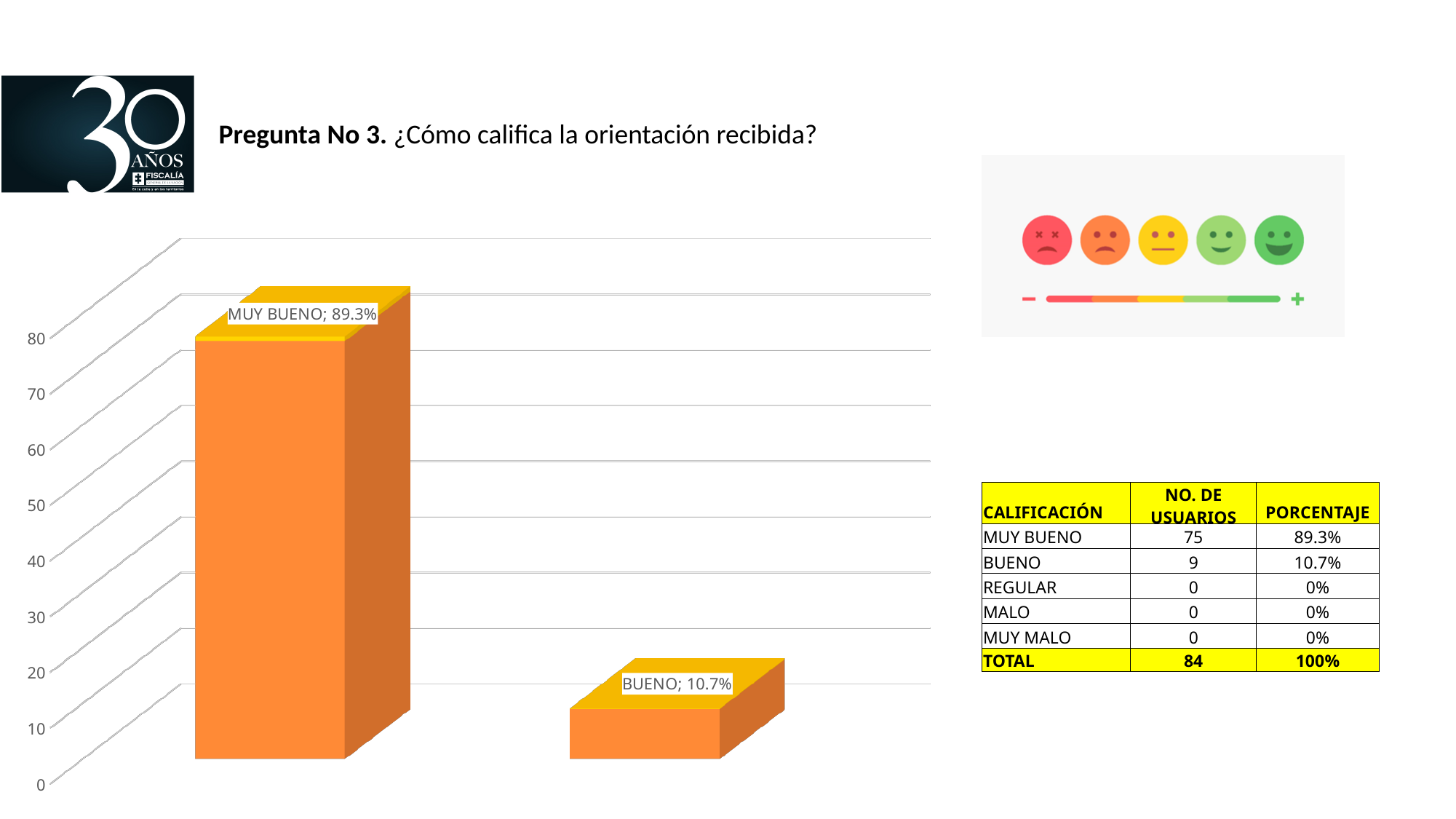
Which category has the lowest bar in the chart? BUENO Is the BUENO bar greater or less than 20 on the vertical axis? less What kind of chart is shown on the slide? bar chart What is the difference between the labelled percentages for MUY BUENO and BUENO? 78.6% What is the data label value shown for the MUY BUENO bar? 89.3% Which category has the highest bar in the chart? MUY BUENO Which is larger, the value for MUY BUENO or the value for BUENO? MUY BUENO Is the MUY BUENO bar greater or less than 60 on the vertical axis? greater How many bars are plotted in the chart? 2 Do the bar values rise or fall from left to right across the chart? fall What is the highest tick value shown on the vertical axis of the chart? 80 What is the data label value shown for the BUENO bar? 10.7%